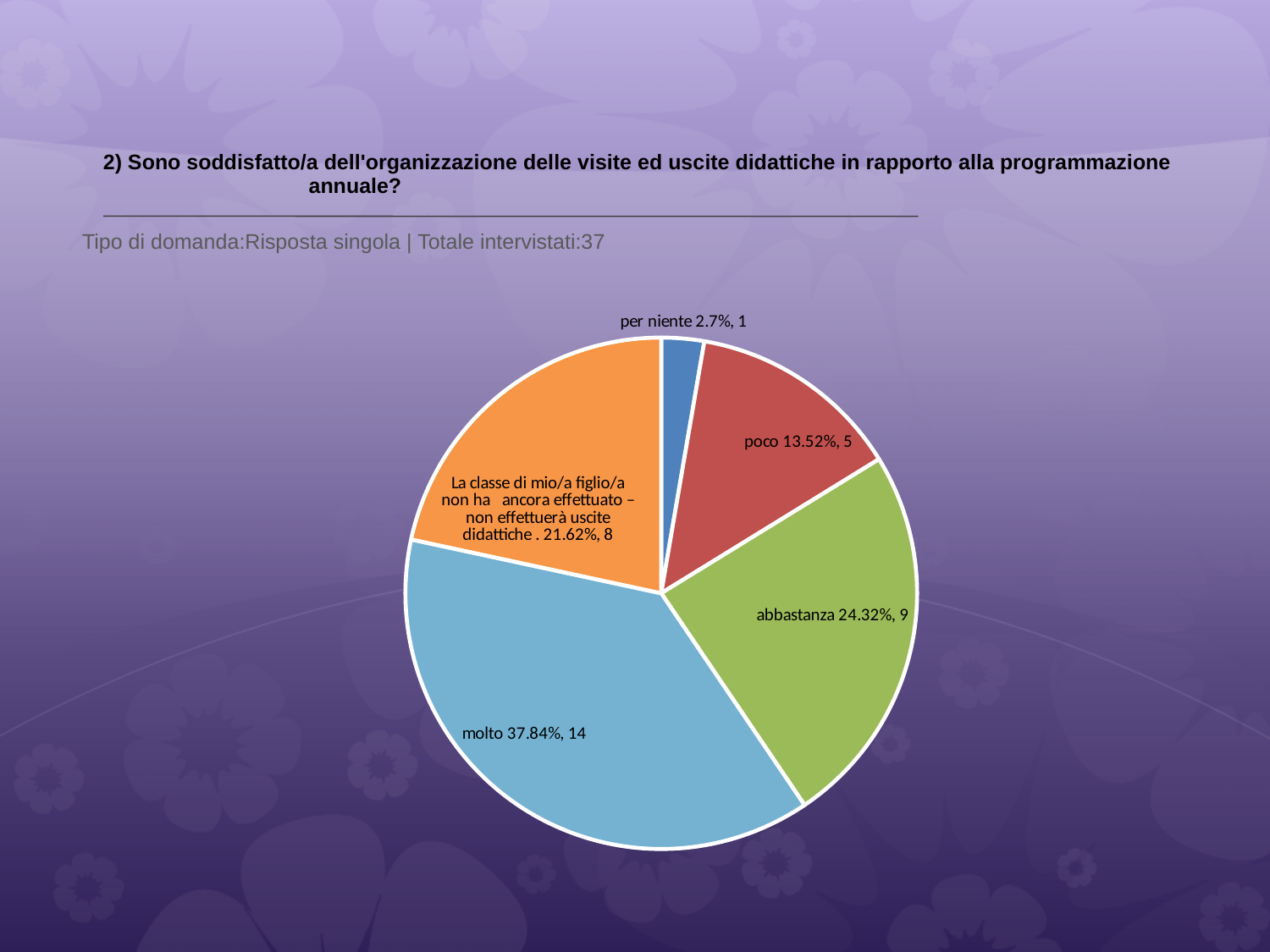
What percentage share does the 'molto' slice have? 37.84% How many slices does the pie chart have? 5 Which category has the smallest slice of the pie? per niente How many respondents answered 'abbastanza'? 9 What percentage share does the 'poco' slice have? 13.52% What kind of chart is shown on the slide? pie chart How many respondents answered 'per niente'? 1 Which category has the largest slice of the pie? molto What is the difference in respondent count between 'molto' and 'abbastanza'? 5 Which has more respondents, 'poco' or 'abbastanza'? abbastanza What colour is the 'molto' slice? light blue What percentage share does the slice for 'La classe di mio/a figlio/a non ha ancora effettuato – non effettuerà uscite didattiche' have? 21.62%